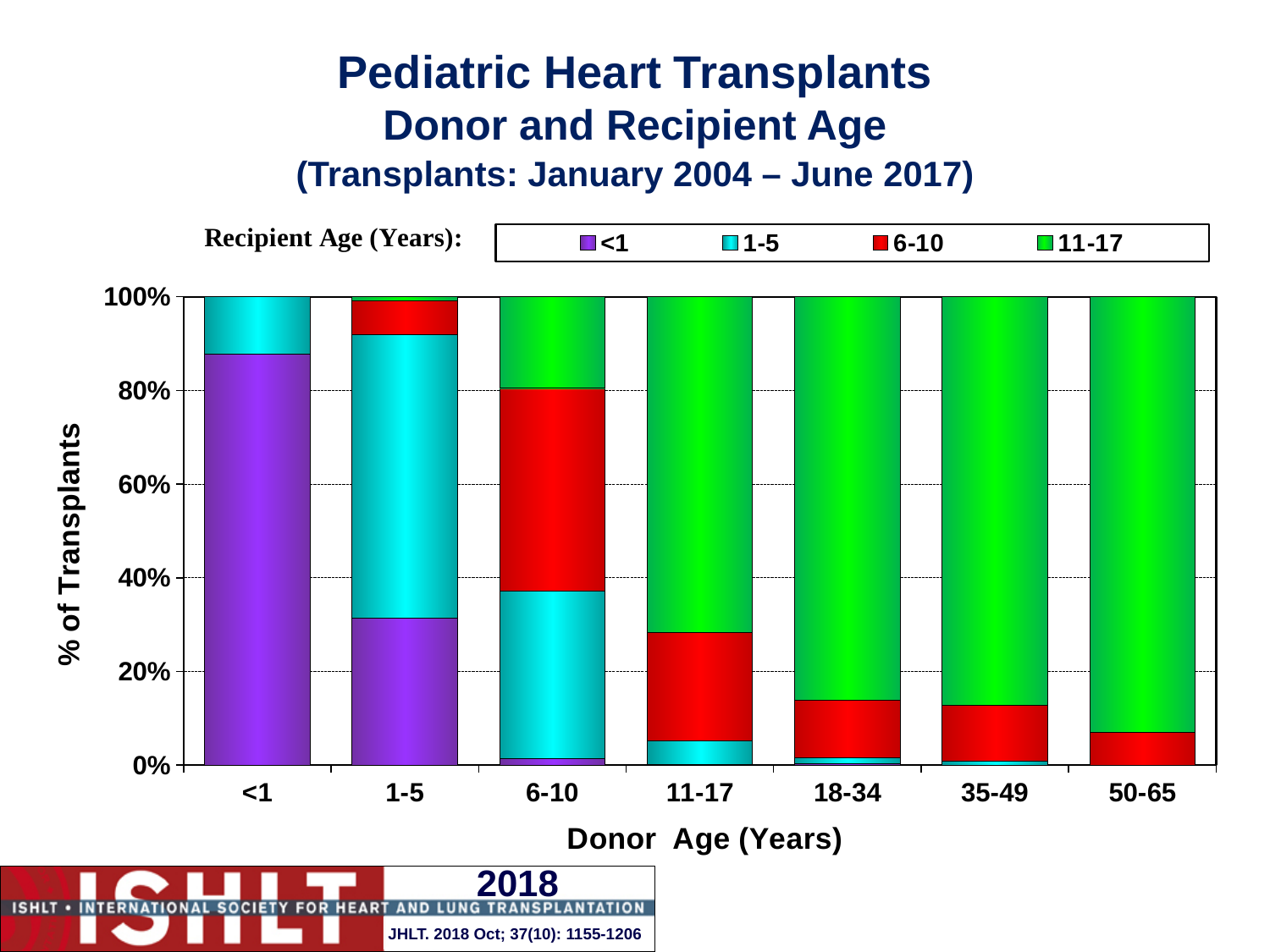
Which donor age group has the smallest share of 11-17 year recipients? <1 Which donor age group has the largest share of 11-17 year recipients? 50-65 What kind of chart is shown on the slide? Stacked bar chart For donors aged 11-17, which recipient group has the larger share: 6-10 or 11-17? 11-17 How many recipient age groups does the legend list? 4 Is the share of 11-17 year recipients for donors aged 6-10 greater or less than 40%? less Is the share of 11-17 year recipients for donors aged 50-65 greater or less than 80%? greater Does the share of 11-17 year recipients rise or fall as donor age increases from 6-10 to 50-65? rise Which donor age group has the larger share of <1 year recipients: <1 or 1-5? <1 Is the share of <1 year recipients for donors aged <1 greater or less than 80%? greater How many donor age groups are shown along the x axis? 7 What is the title of the x axis? Donor Age (Years)